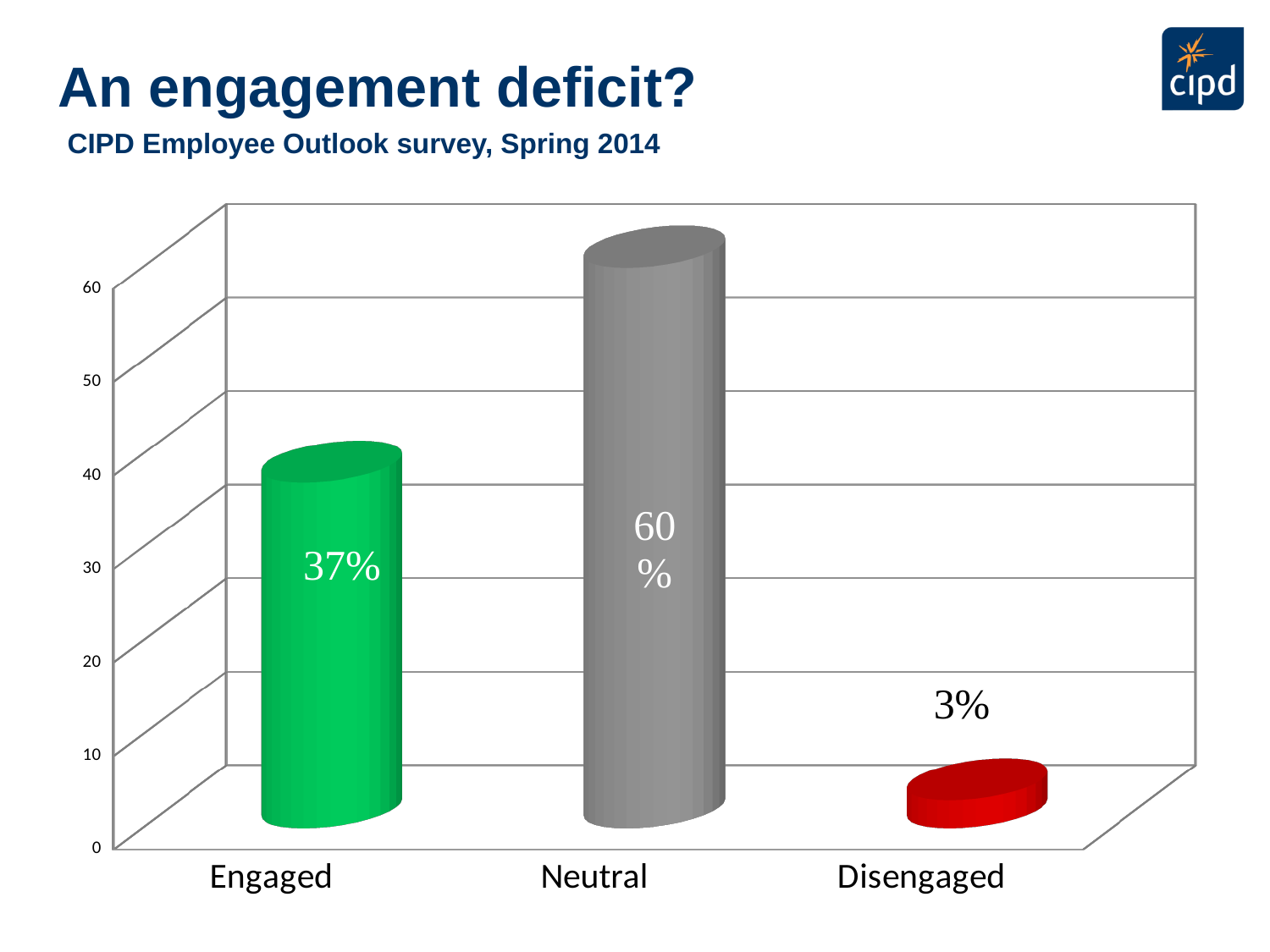
What is the difference between the Engaged and Disengaged values? 34% What colour is the bar for Disengaged? red What is the value for Engaged? 37% What is the difference between the Neutral and Engaged values? 23% Which category has the lowest value? Disengaged Which is larger, the value for Engaged or the value for Disengaged? Engaged What kind of chart is shown on the slide? bar chart What is the value for Neutral? 60% What is the value for Disengaged? 3% How many categories are shown on the x axis? 3 Is the value for Engaged greater or less than 40? less Which category has the highest value? Neutral